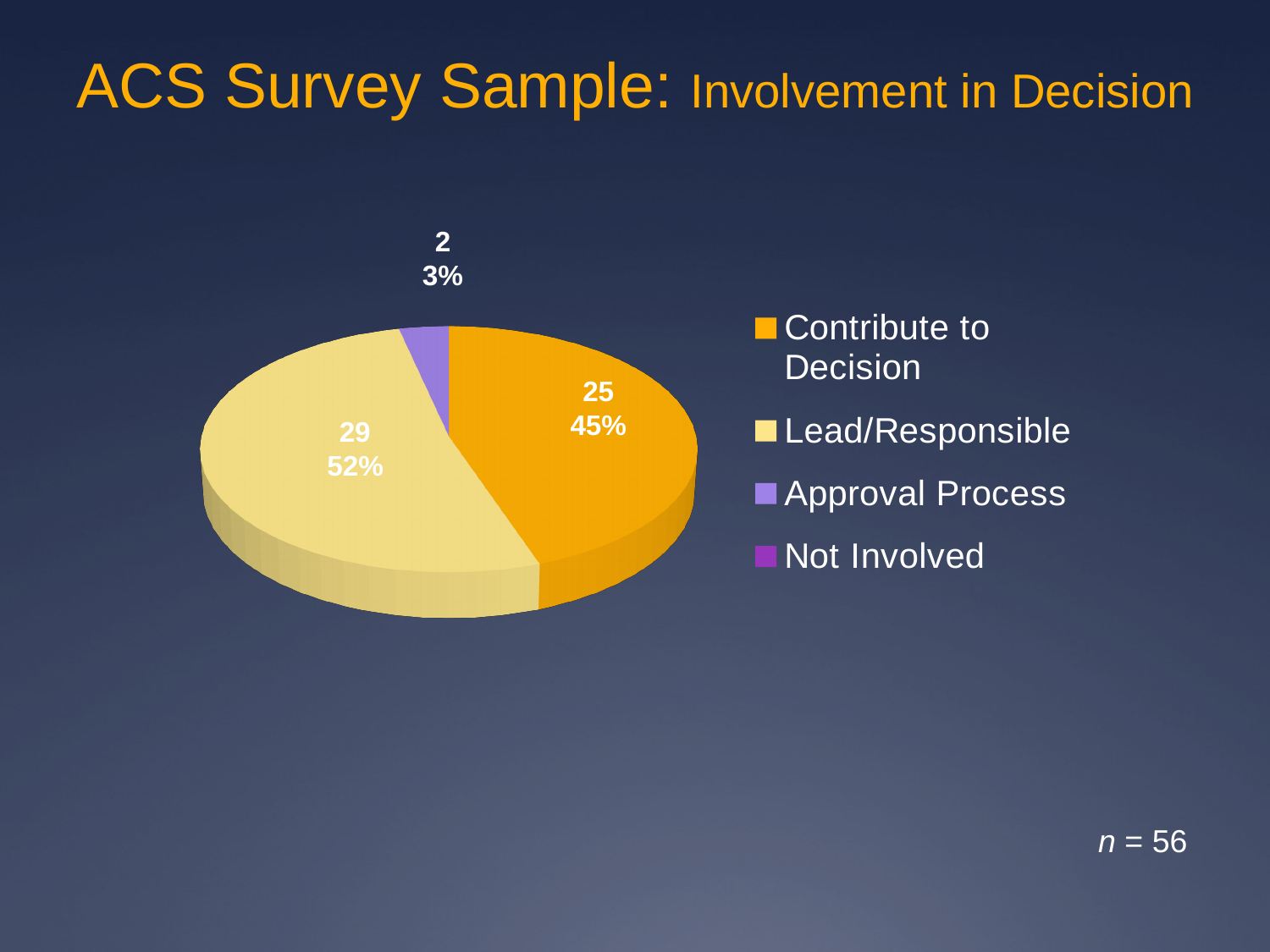
Which category with a visible slice has the smallest share of the pie? Approval Process How many respondents are in the Contribute to Decision slice? 25 How many entries does the legend list? 4 What percentage of the pie is Approval Process? 3% What kind of chart is shown on the slide? pie chart Which is larger, the Contribute to Decision slice or the Approval Process slice? Contribute to Decision How many respondents are in the Lead/Responsible slice? 29 What is the difference in count between Lead/Responsible and Contribute to Decision? 4 Which category has the largest slice of the pie? Lead/Responsible What is the sample size (n) shown on the slide? 56 What percentage of the pie is Contribute to Decision? 45% What colour is the Lead/Responsible slice? pale yellow